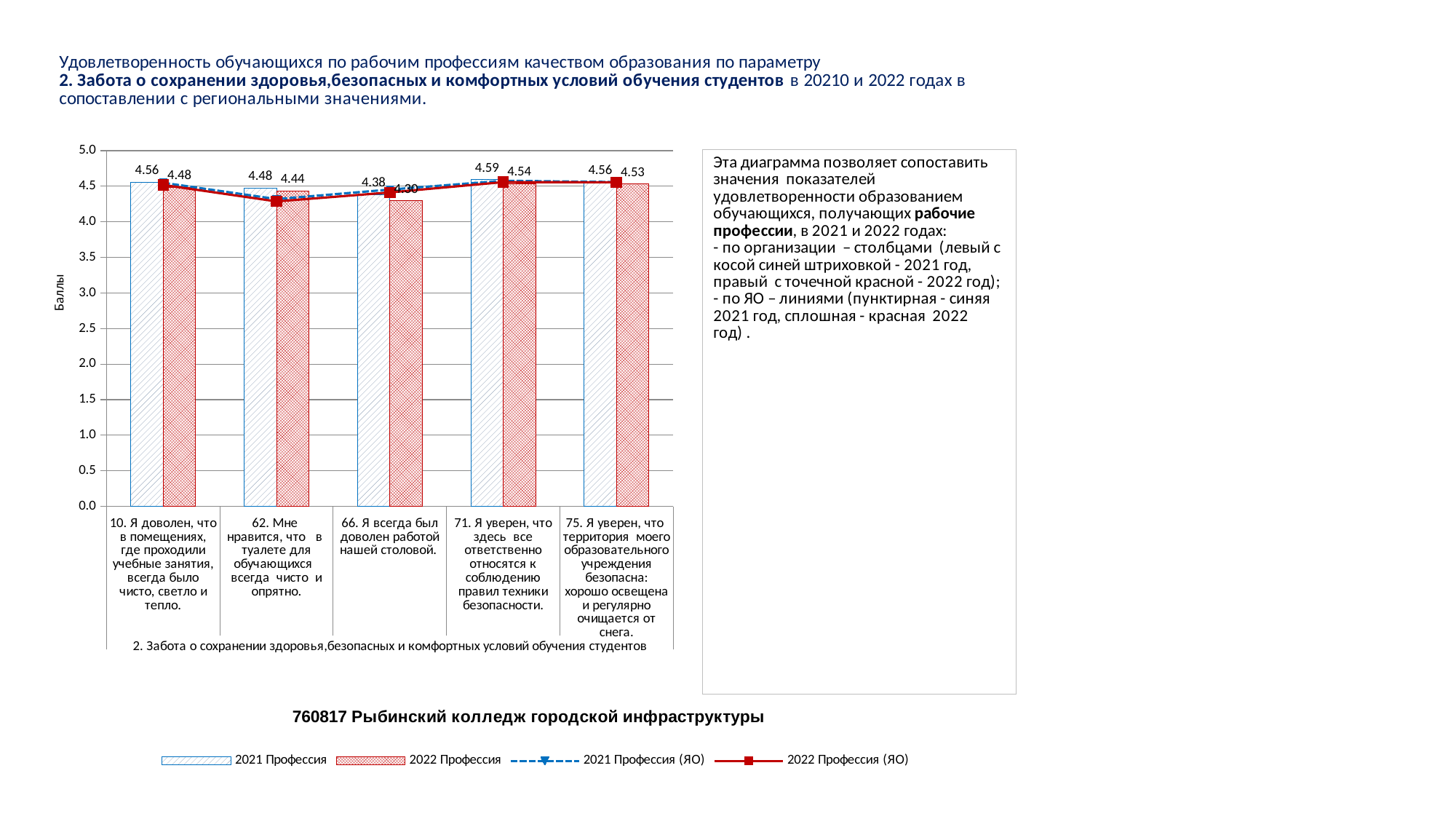
For item 71, which is larger: the 2021 Профессия value or the 2022 Профессия value? 2021 Профессия (4.59) Is the 2022 Профессия value for item 66 greater or less than 4.0? greater How many survey items (categories) are shown on the x axis? 5 What is the 2021 Профессия value for item 71 (Я уверен, что здесь все ответственно относятся к соблюдению правил техники безопасности)? 4.59 How many series does the legend list? 4 What is the 2022 Профессия value for item 75 (Я уверен, что территория моего образовательного учреждения безопасна)? 4.53 What is the 2022 Профессия value for item 62 (Мне нравится, что в туалете для обучающихся всегда чисто и опрятно)? 4.44 What is the difference between the 2021 Профессия and 2022 Профессия values for item 10? 0.08 What is the 2021 Профессия value for item 10 (Я доволен, что в помещениях, где проходили учебные занятия, всегда было чисто, светло и тепло)? 4.56 Which item has the lowest 2021 Профессия value? 66. Я всегда был доволен работой нашей столовой. What is the title of the vertical axis? Баллы Which item has the highest 2021 Профессия value? 71. Я уверен, что здесь все ответственно относятся к соблюдению правил техники безопасности.